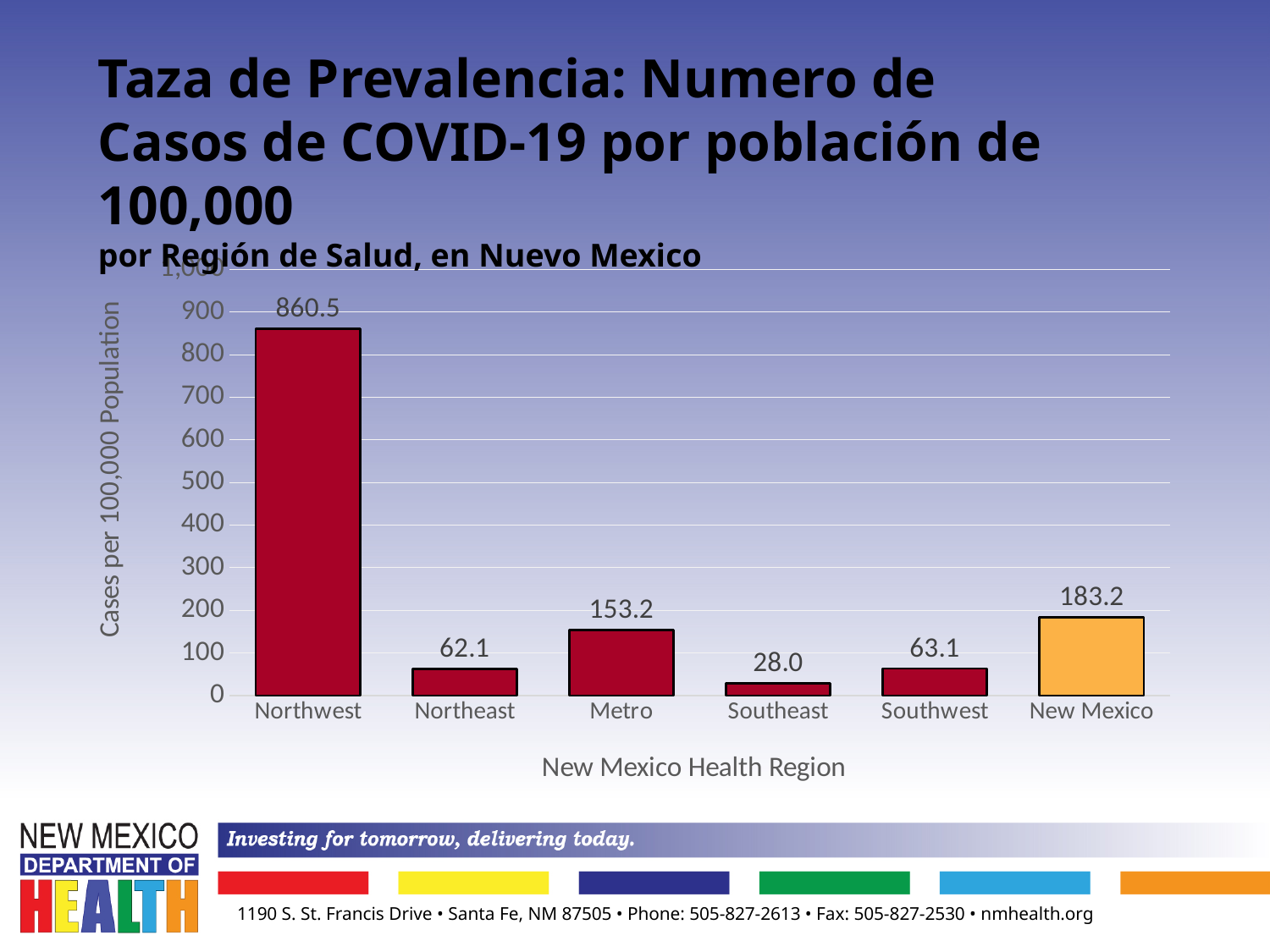
What is the value for Northwest? 860.5 What is the label of the y axis? Cases per 100,000 Population How many categories are shown on the x axis? 6 Is the value for Northwest greater or less than 800? greater What is the difference between the values for Northwest and New Mexico? 677.3 Which region has the highest cases per 100,000 population? Northwest What is the value for New Mexico? 183.2 What kind of chart is shown on the slide? bar chart Which is larger, the value for Metro or the value for New Mexico? New Mexico Which region has the lowest cases per 100,000 population? Southeast What is the value for Metro? 153.2 What is the difference between the values for Metro and Southeast? 125.2